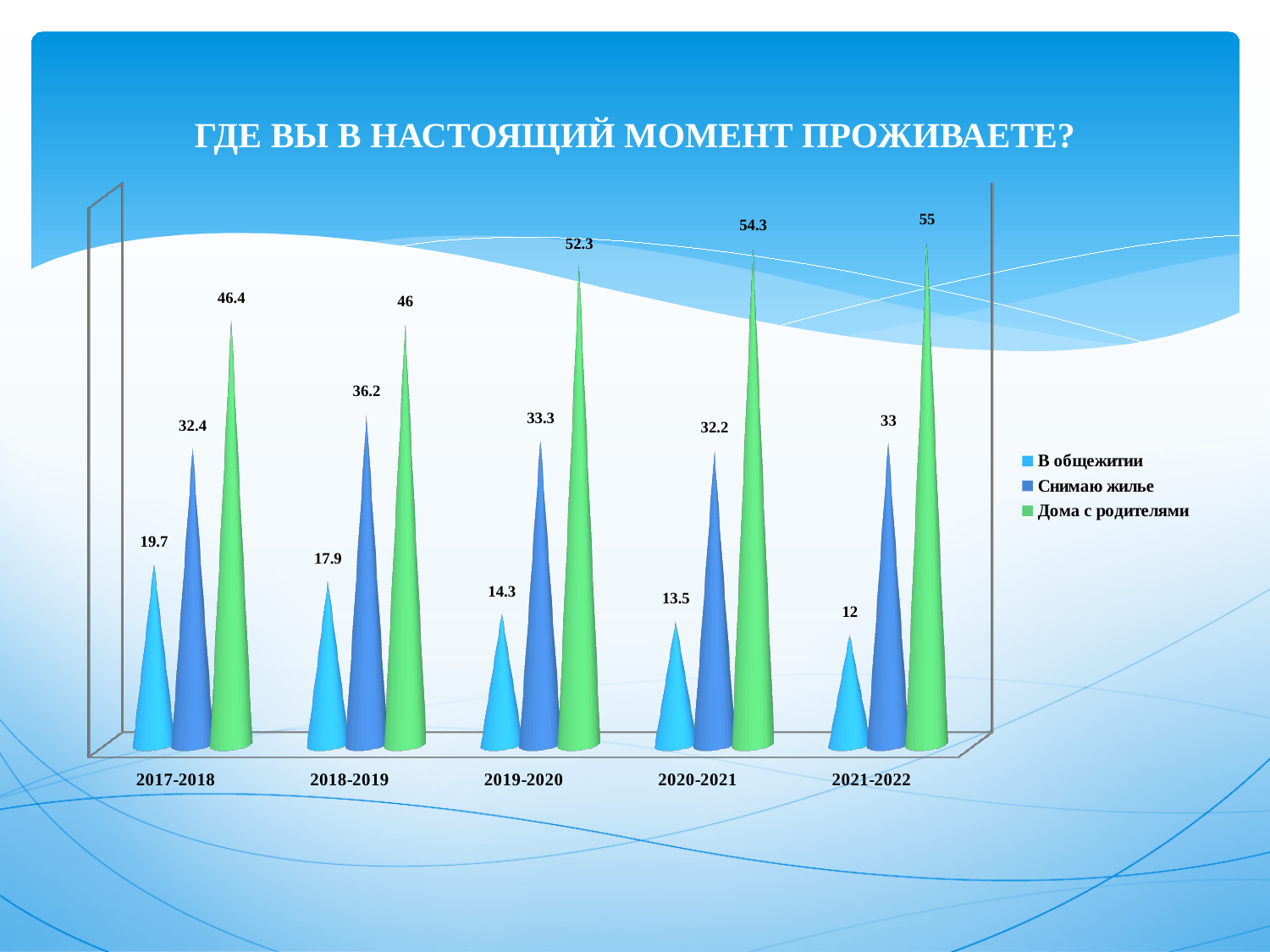
How many year categories are shown on the x axis? 5 Which is larger in 2020-2021: "Снимаю жилье" or "Дома с родителями"? Дома с родителями What is the value for "Дома с родителями" in 2021-2022? 55 What is the value for "В общежитии" in 2019-2020? 14.3 Does the value for "В общежитии" rise or fall from 2017-2018 to 2021-2022? Fall In which year is the value for "В общежитии" the lowest? 2021-2022 What is the difference between "Дома с родителями" and "В общежитии" in 2017-2018? 26.7 In which year is the value for "Дома с родителями" the highest? 2021-2022 What is the title of the chart? ГДЕ ВЫ В НАСТОЯЩИЙ МОМЕНТ ПРОЖИВАЕТЕ? What is the value for "Снимаю жилье" in 2018-2019? 36.2 What kind of chart is shown on the slide? Bar chart How many series does the legend list? 3